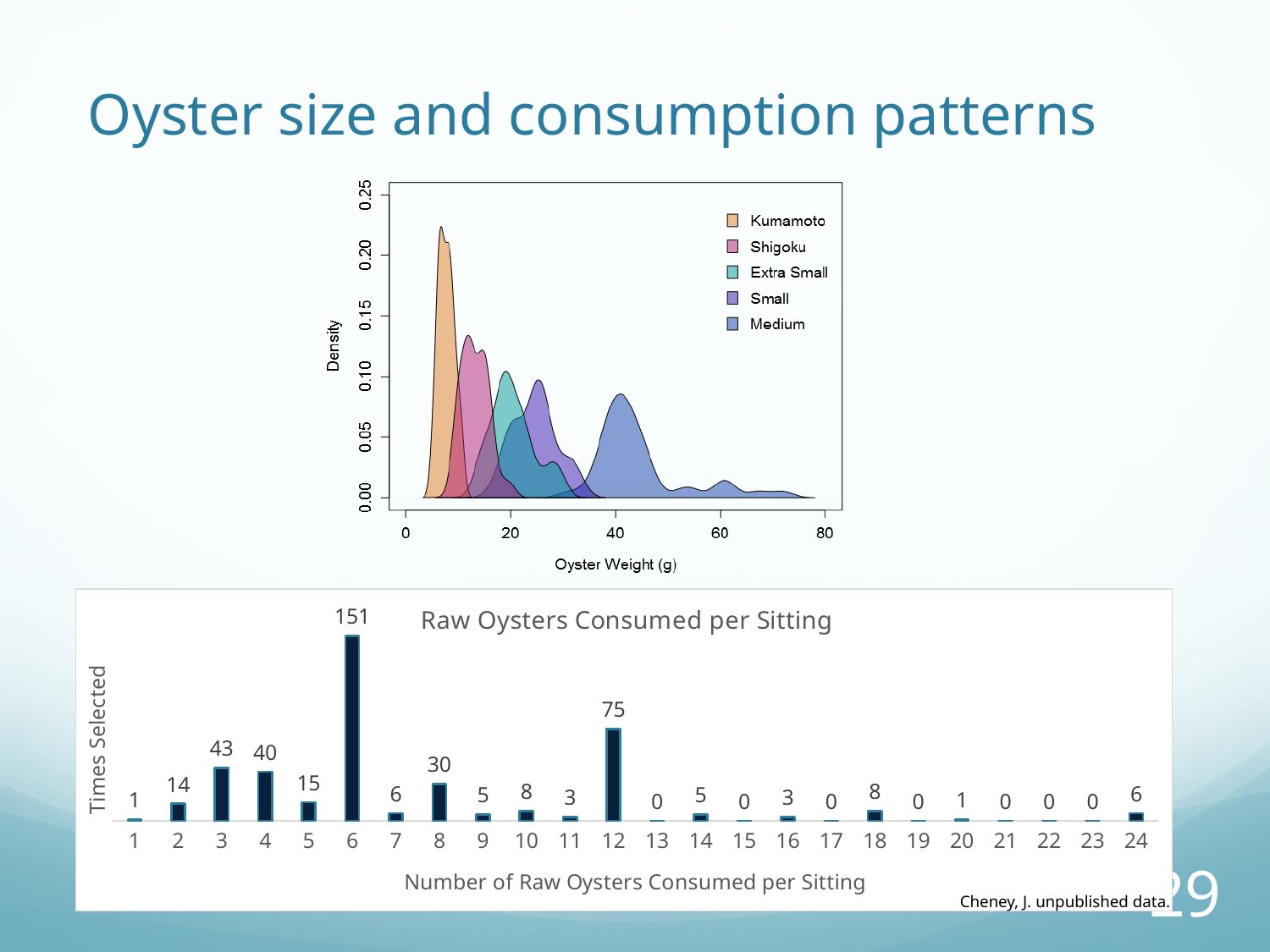
In the top density chart, how many oyster types does the legend list? 5 In the 'Raw Oysters Consumed per Sitting' chart, how many categories are shown on the x axis? 24 In the 'Raw Oysters Consumed per Sitting' chart, what is the label of the y axis? Times Selected In the top density chart, is the peak density for Kumamoto greater or less than 0.20? greater In the 'Raw Oysters Consumed per Sitting' chart, which number of oysters has the highest times selected? 6 In the top density chart, is the peak density for Medium greater or less than 0.10? less What kind of chart is 'Raw Oysters Consumed per Sitting'? Bar chart In the 'Raw Oysters Consumed per Sitting' chart, which is larger, the value for 8 oysters or the value for 5 oysters? 8 oysters In the 'Raw Oysters Consumed per Sitting' chart, what is the difference between the values for 3 and 4 oysters? 3 In the 'Raw Oysters Consumed per Sitting' chart, how many times was 6 oysters selected? 151 In the 'Raw Oysters Consumed per Sitting' chart, what is the value for 12 oysters? 75 In the 'Raw Oysters Consumed per Sitting' chart, what is the value for 24 oysters? 6